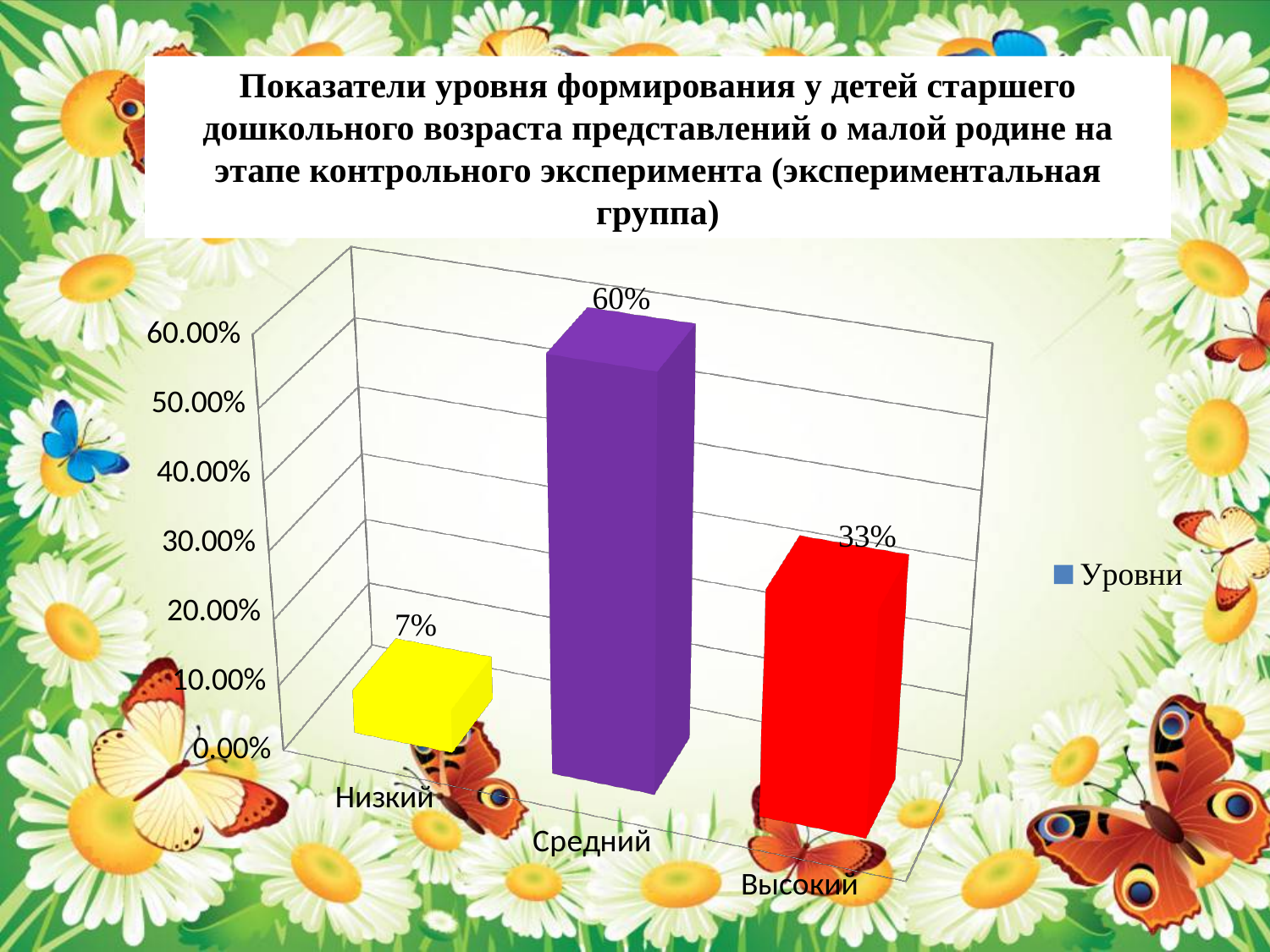
What is the difference between the values for Высокий and Низкий? 26% What is the value for Высокий? 33% Which category has the highest value? Средний Which category has the lowest value? Низкий What is the difference between the values for Средний and Высокий? 27% Which is larger, the value for Высокий or the value for Низкий? Высокий What is the value for Средний? 60% What kind of chart is shown on the slide? bar chart What is the value for Низкий? 7% What series name does the legend list? Уровни How many categories are shown on the x axis? 3 Is the value for Средний greater or less than 50.00%? greater